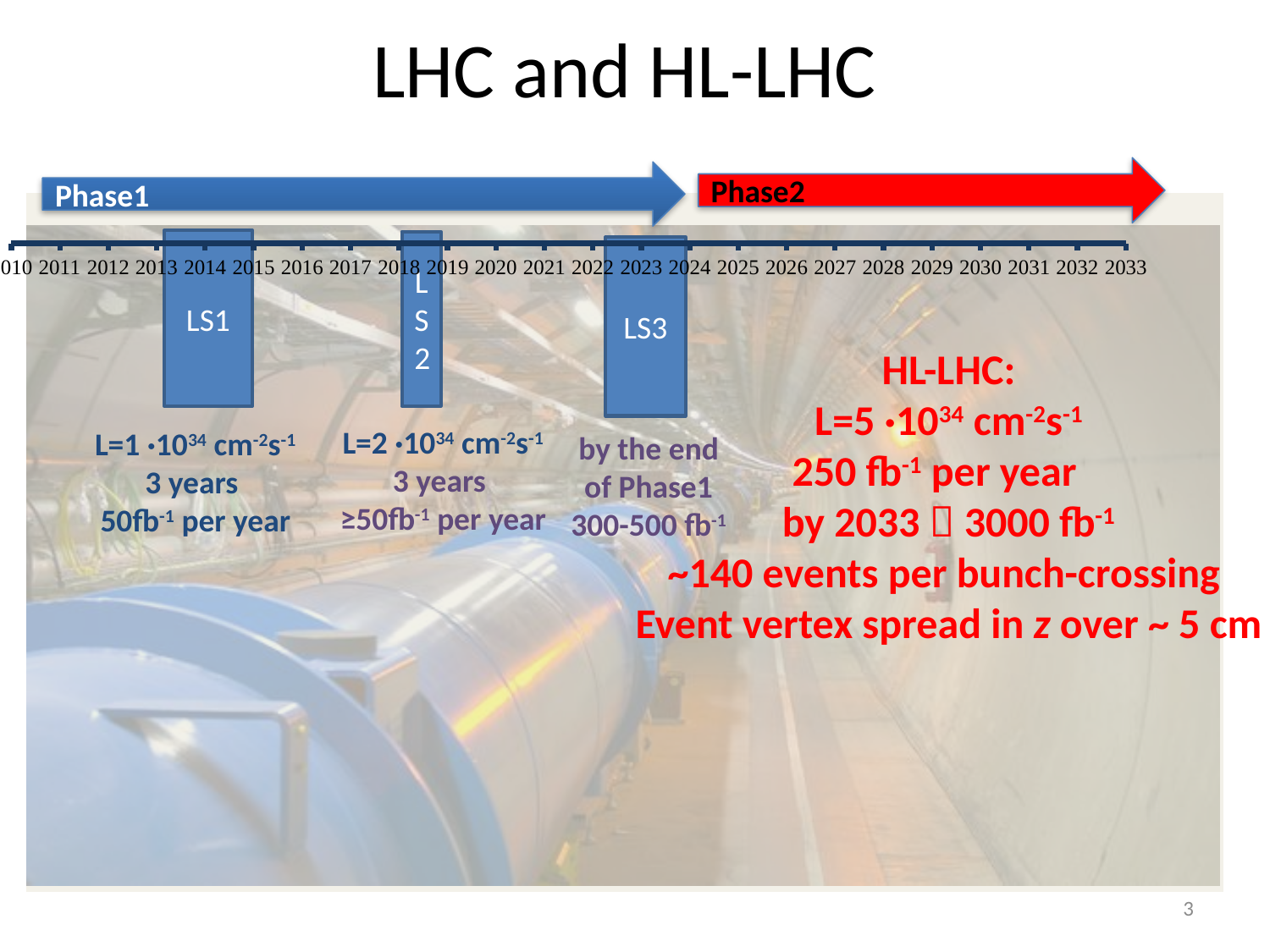
What total integrated luminosity is given for HL-LHC by 2033? 3000 fb-1 What are the labels of the three shutdown blocks on the timeline, from left to right? LS1, LS2, LS3 What are the two phases labelled by the arrows above the timeline? Phase1 and Phase2 How many long shutdown (LS) blocks are shown on the timeline? 3 What instantaneous luminosity is given for HL-LHC? L=5 ·10^34 cm-2s-1 What integrated luminosity per year is given for the period after LS2? ≥50fb-1 per year How many events per bunch-crossing are quoted for HL-LHC? ~140 What integrated luminosity is expected by the end of Phase1? 300-500 fb-1 What integrated luminosity per year is given for the period after LS1? 50fb-1 per year What is the first year shown on the timeline axis? 2010 What is the last year shown on the timeline axis? 2033 What integrated luminosity per year is given for HL-LHC? 250 fb-1 per year